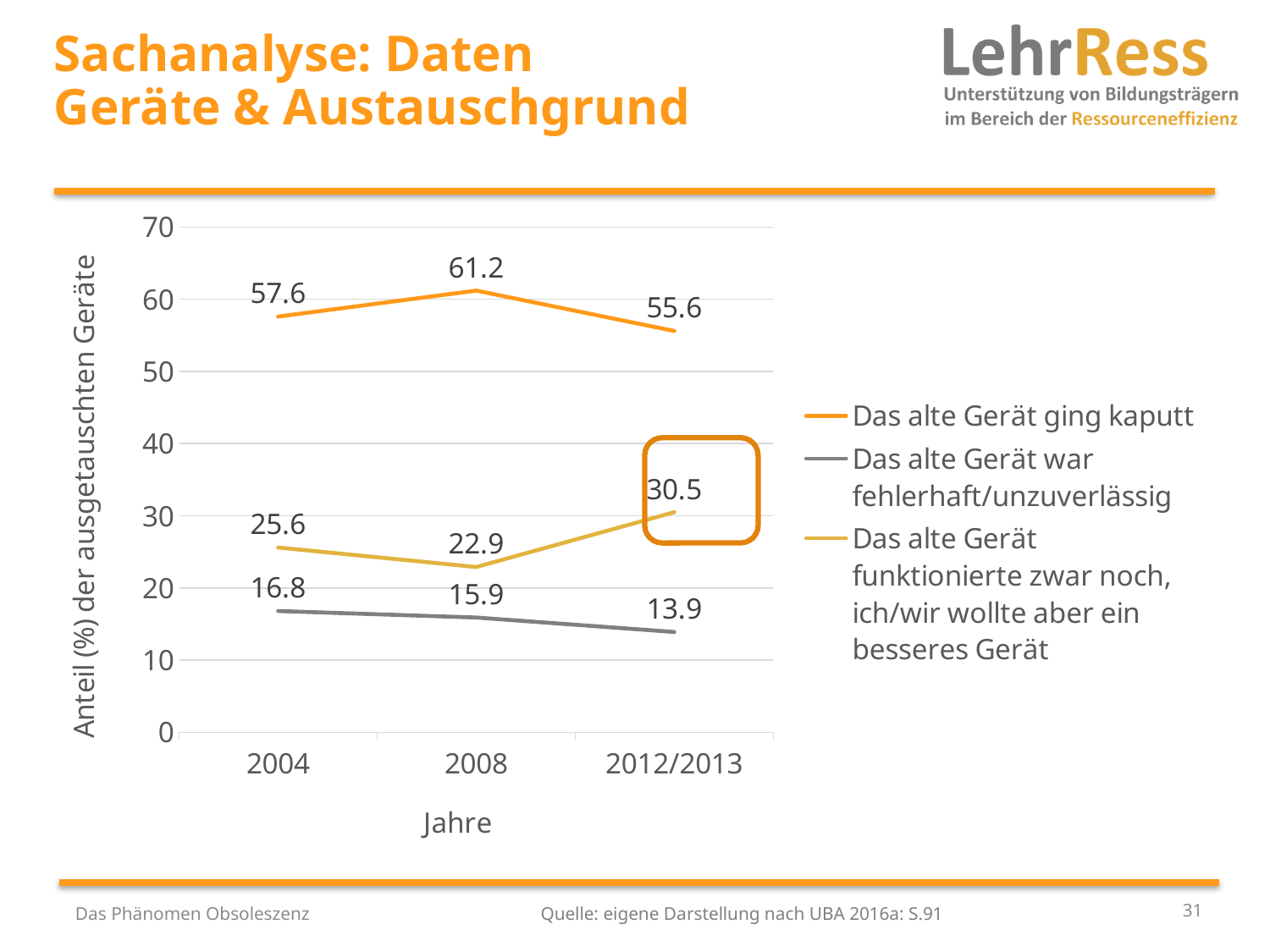
What is the value for 'Das alte Gerät funktionierte zwar noch, ich/wir wollte aber ein besseres Gerät' in 2004? 25.6 Which is larger in 2004: 'Das alte Gerät war fehlerhaft/unzuverlässig' or 'Das alte Gerät funktionierte zwar noch, ich/wir wollte aber ein besseres Gerät'? Das alte Gerät funktionierte zwar noch, ich/wir wollte aber ein besseres Gerät What is the difference between the 2012/2013 and 2004 values for 'Das alte Gerät funktionierte zwar noch, ich/wir wollte aber ein besseres Gerät'? 4.9 Does the value for 'Das alte Gerät war fehlerhaft/unzuverlässig' rise or fall from 2004 to 2012/2013? fall How many points on the x axis (Jahre) are plotted? 3 What is the value for 'Das alte Gerät ging kaputt' in 2008? 61.2 In which year is 'Das alte Gerät funktionierte zwar noch, ich/wir wollte aber ein besseres Gerät' lowest? 2008 In which year does 'Das alte Gerät ging kaputt' reach its highest value? 2008 What is the value for 'Das alte Gerät war fehlerhaft/unzuverlässig' in 2012/2013? 13.9 What is the label of the y axis? Anteil (%) der ausgetauschten Geräte How many series does the legend list? 3 What type of chart is shown on the slide? line chart